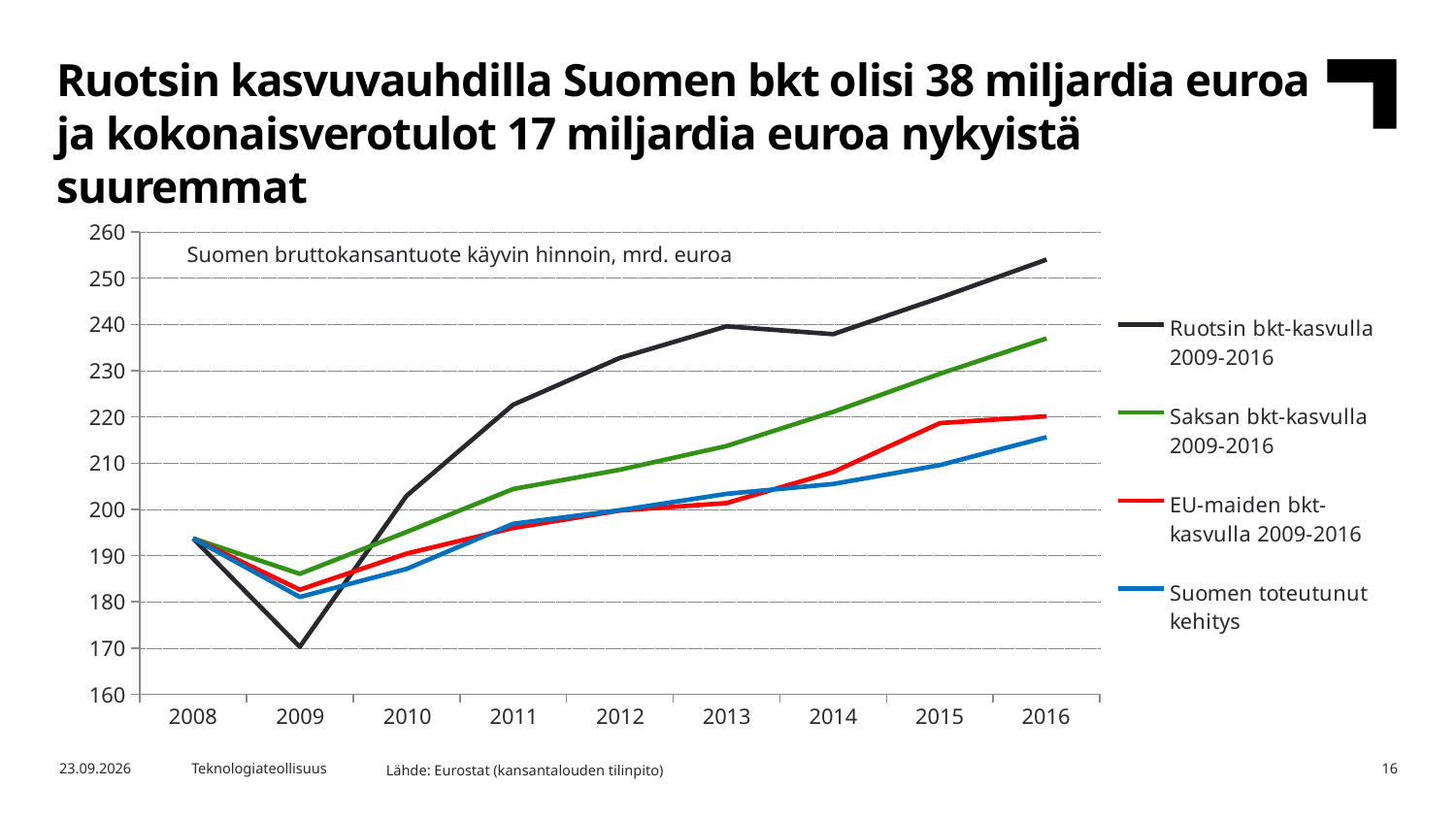
Which series has the highest value in 2016? Ruotsin bkt-kasvulla 2009-2016 How many series does the legend list? 4 What kind of chart is shown on the slide? line chart Does the Ruotsin bkt-kasvulla 2009-2016 line rise or fall from 2009 to 2016? rise Which series has the lowest value in 2009? Ruotsin bkt-kasvulla 2009-2016 How many years are plotted along the x axis? 9 Which series is drawn with a blue line? Suomen toteutunut kehitys Is the value for Saksan bkt-kasvulla 2009-2016 in 2009 greater or less than 190? less What is the title shown inside the chart area? Suomen bruttokansantuote käyvin hinnoin, mrd. euroa In 2015, which is larger: EU-maiden bkt-kasvulla 2009-2016 or Suomen toteutunut kehitys? EU-maiden bkt-kasvulla 2009-2016 Is the value for Ruotsin bkt-kasvulla 2009-2016 in 2016 greater or less than 250? greater Which series has the lowest value in 2016? Suomen toteutunut kehitys